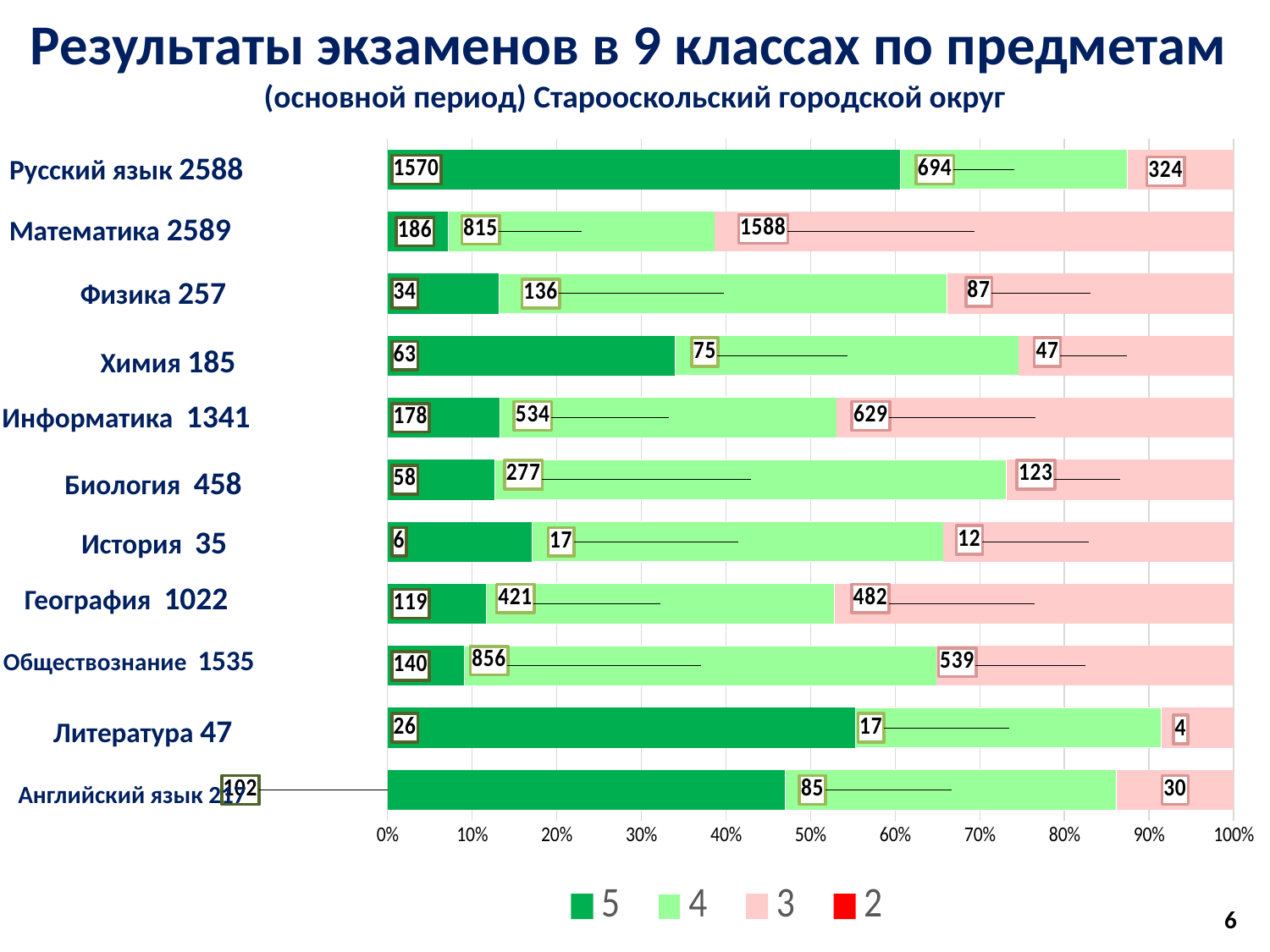
What is the number of grade-3 results for Математика? 1588 What is the difference between the grade-4 and grade-5 counts for Физика? 102 What is the total of the values labelled on the bar for Химия? 185 Is the share of grade-5 results for Математика greater or less than 10%? less How many grade-5 results are shown for Русский язык? 1570 How many grade-4 results are shown for Обществознание? 856 Which is larger for Информатика: the number of grade-3 results or the number of grade-4 results? grade-3 results (629) How many series does the legend list? 4 How many subjects are shown in the chart? 11 Which subject has the largest number of grade-5 results? Русский язык Which subject has the smallest number of grade-3 results? Литература Is the share of grade-5 results for Русский язык greater or less than 50%? greater